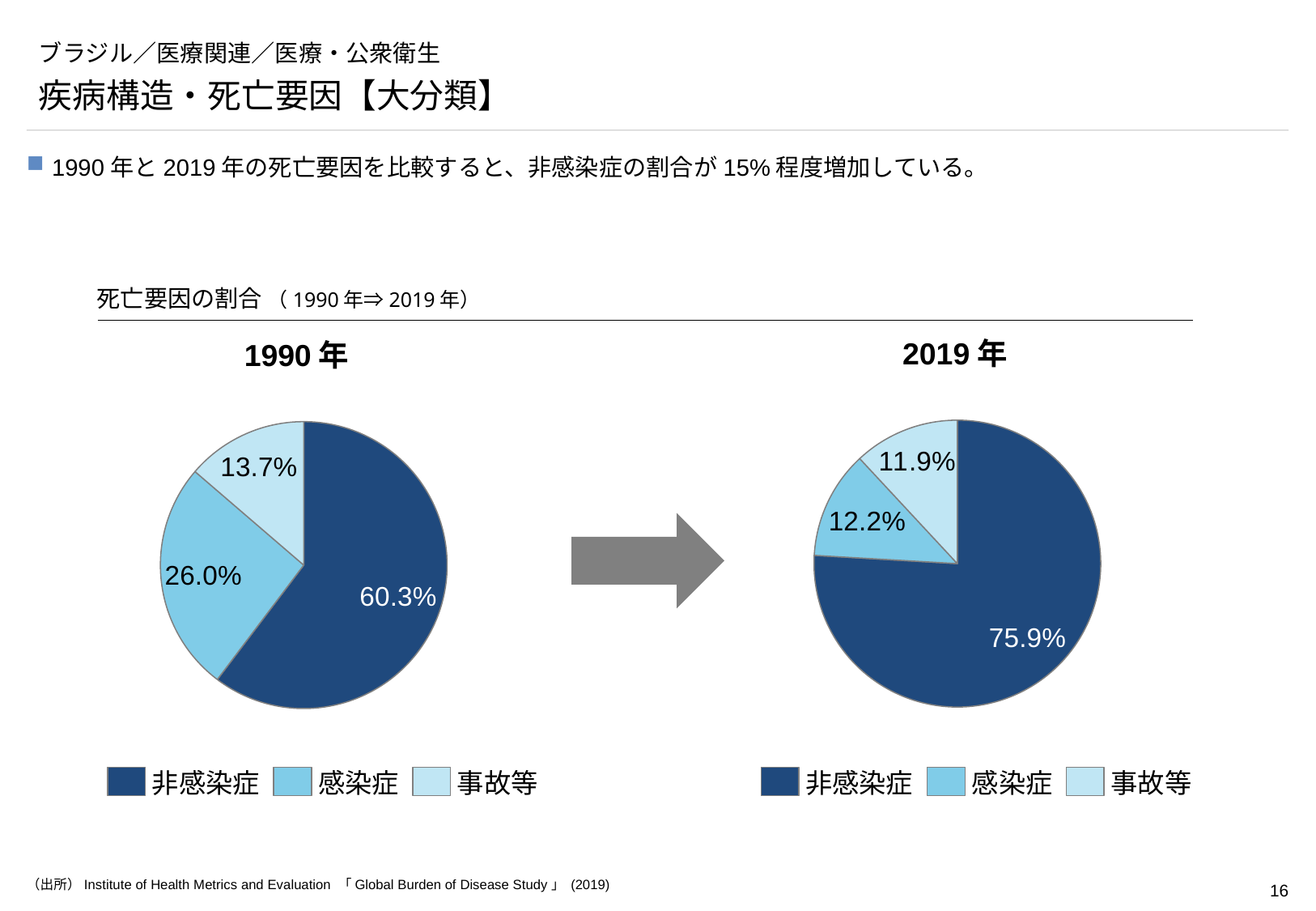
In the 2019年 pie chart, what share is 事故等? 11.9% What type of chart is used for the 1990年 and 2019年 data? Pie chart In the 1990年 pie chart, which category has the largest share? 非感染症 In the 1990年 pie chart, what share is 感染症? 26.0% In the 2019年 pie chart, which category has the largest share? 非感染症 In the 1990年 pie chart, what share is 事故等? 13.7% In the 1990年 pie chart, what share is 非感染症? 60.3% What is the difference between the 非感染症 share in the 2019年 pie chart and in the 1990年 pie chart? 15.6% How many categories does the legend of the 1990年 pie chart list? 3 In the 2019年 pie chart, what share is 感染症? 12.2% In the 2019年 pie chart, what share is 非感染症? 75.9% In the 1990年 pie chart, which category has the smallest share? 事故等